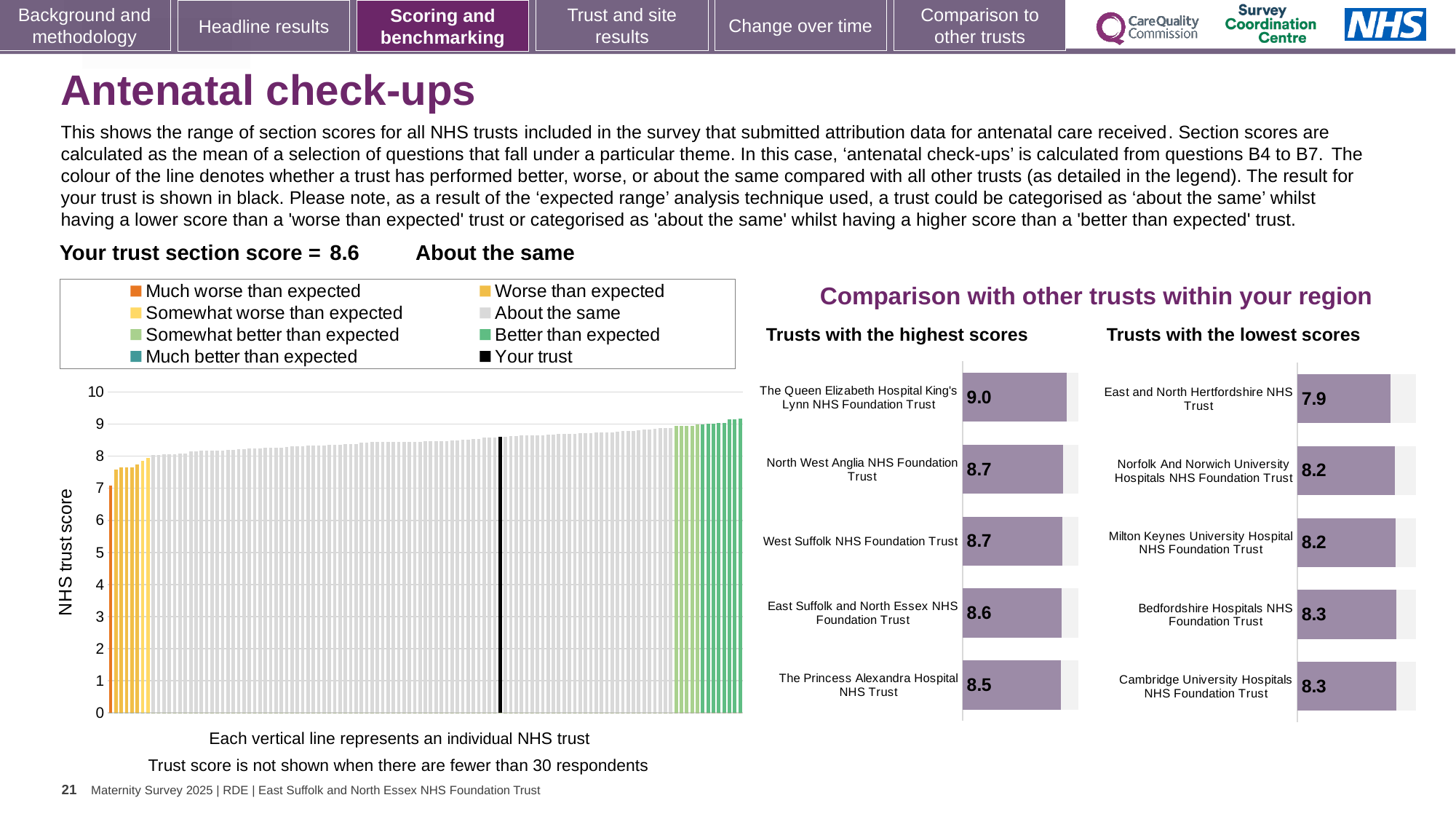
In the 'Trusts with the highest scores' chart, what is the score for The Princess Alexandra Hospital NHS Trust? 8.5 In the 'Trusts with the highest scores' chart, what is the score for The Queen Elizabeth Hospital King's Lynn NHS Foundation Trust? 9.0 In the 'Trusts with the lowest scores' chart, what is the score for East and North Hertfordshire NHS Trust? 7.9 What is the section score for your trust shown on the slide? 8.6 In the 'Trusts with the lowest scores' chart, which trust has the lowest score? East and North Hertfordshire NHS Trust How many trusts are shown in the 'Trusts with the lowest scores' chart? 5 What is the difference between the score of The Queen Elizabeth Hospital King's Lynn NHS Foundation Trust in the highest scores chart and East and North Hertfordshire NHS Trust in the lowest scores chart? 1.1 In the main 'NHS trust score' chart, do the values rise or fall from left to right? Rise How many entries does the legend of the main 'NHS trust score' chart list? 8 In the 'Trusts with the highest scores' chart, which trust has the highest score? The Queen Elizabeth Hospital King's Lynn NHS Foundation Trust What kind of chart is the main chart with the 'NHS trust score' axis? Bar chart In the 'Trusts with the highest scores' chart, which has the larger score: North West Anglia NHS Foundation Trust or The Princess Alexandra Hospital NHS Trust? North West Anglia NHS Foundation Trust